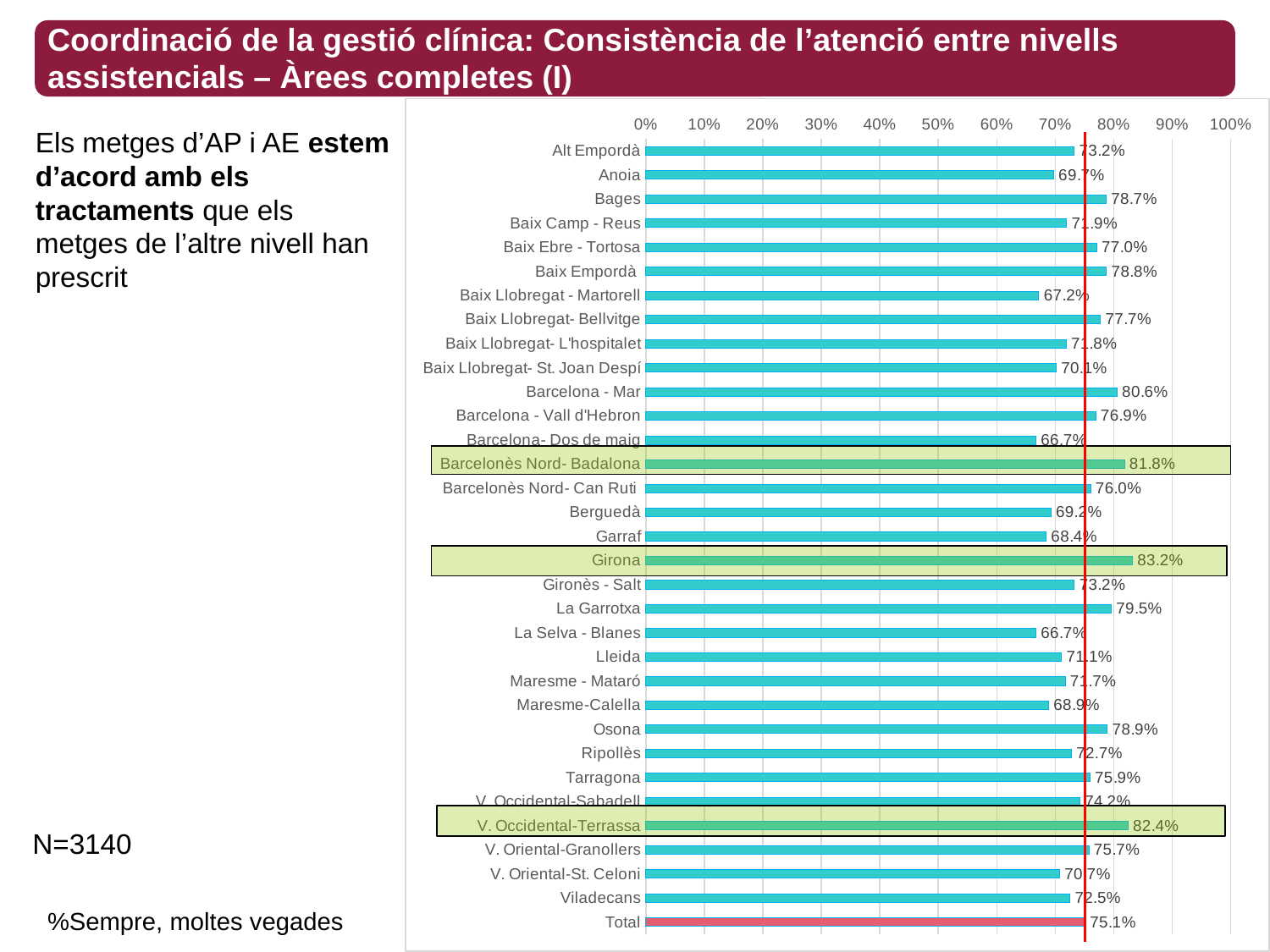
What is the value for Osona? 78.9% What is the value for Girona? 83.2% What is the value for Barcelona - Mar? 80.6% What is the difference between the value for Girona and the value for Total? 8.1 percentage points Is the value for Baix Llobregat - Martorell greater or less than 70%? less What kind of chart is shown on the slide? Bar chart Which is larger, the value for Barcelona - Mar or the value for Baix Llobregat - Martorell? Barcelona - Mar Which area has the highest value? Girona How many bars are plotted in the chart, including Total? 33 What is the difference between the value for Barcelona - Mar and the value for Baix Llobregat - Martorell? 13.4 percentage points What is the value for Total? 75.1% What is the value for La Garrotxa? 79.5%